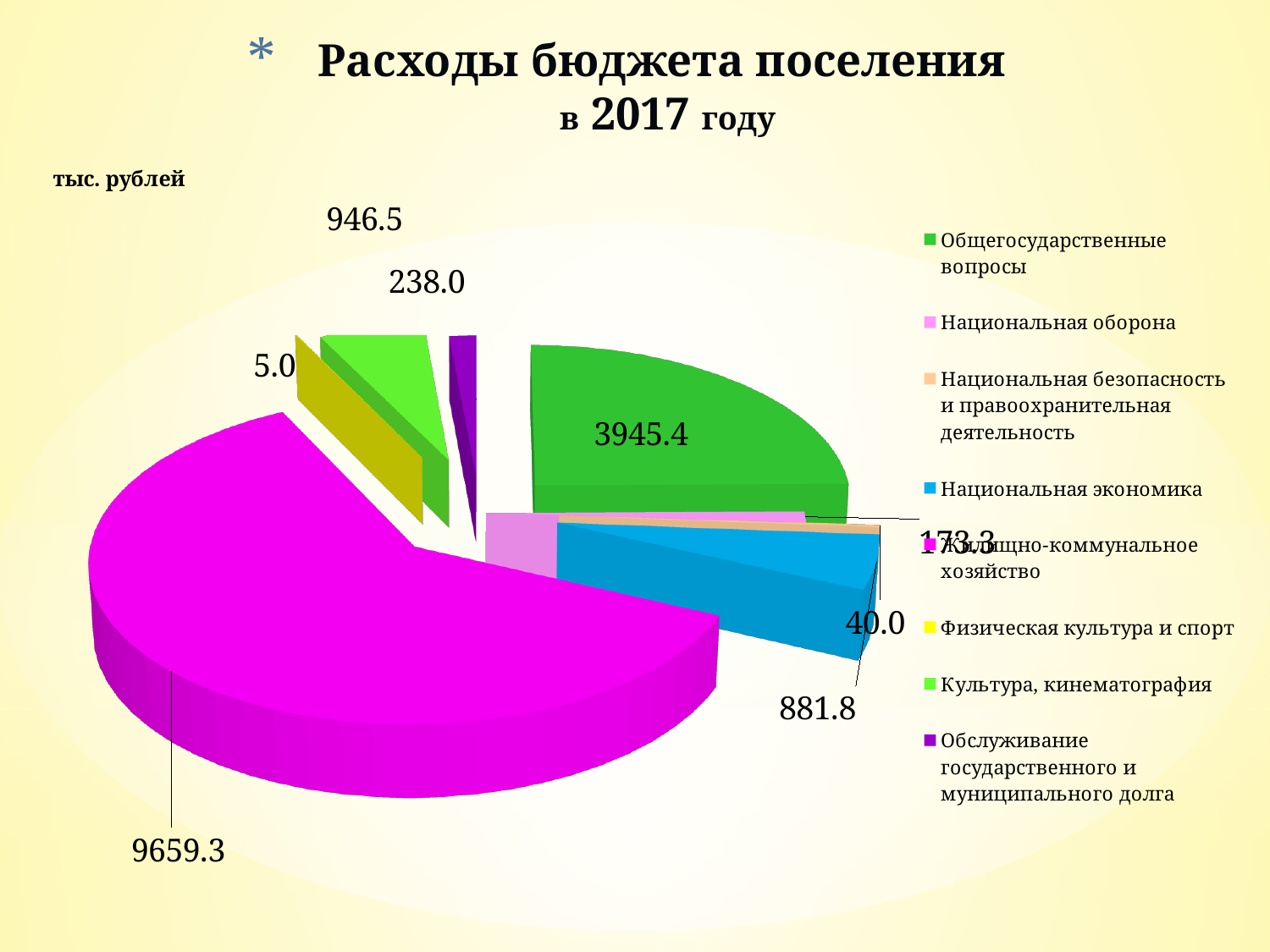
What is the value for Жилищно-коммунальное хозяйство? 9659.3 What is the value for Общегосударственные вопросы? 3945.4 What is the value for Физическая культура и спорт? 5.0 What kind of chart is shown on the slide? pie chart What is the difference between Жилищно-коммунальное хозяйство and Общегосударственные вопросы? 5713.9 In what units are the values on the chart given? тыс. рублей Which category has the smallest value? Физическая культура и спорт Which is larger: Жилищно-коммунальное хозяйство or Общегосударственные вопросы? Жилищно-коммунальное хозяйство Which category has the largest share of the pie? Жилищно-коммунальное хозяйство What is the difference between Общегосударственные вопросы and Национальная экономика? 3063.6 How many categories does the legend of the pie chart list? 8 What is the value for Национальная экономика? 881.8